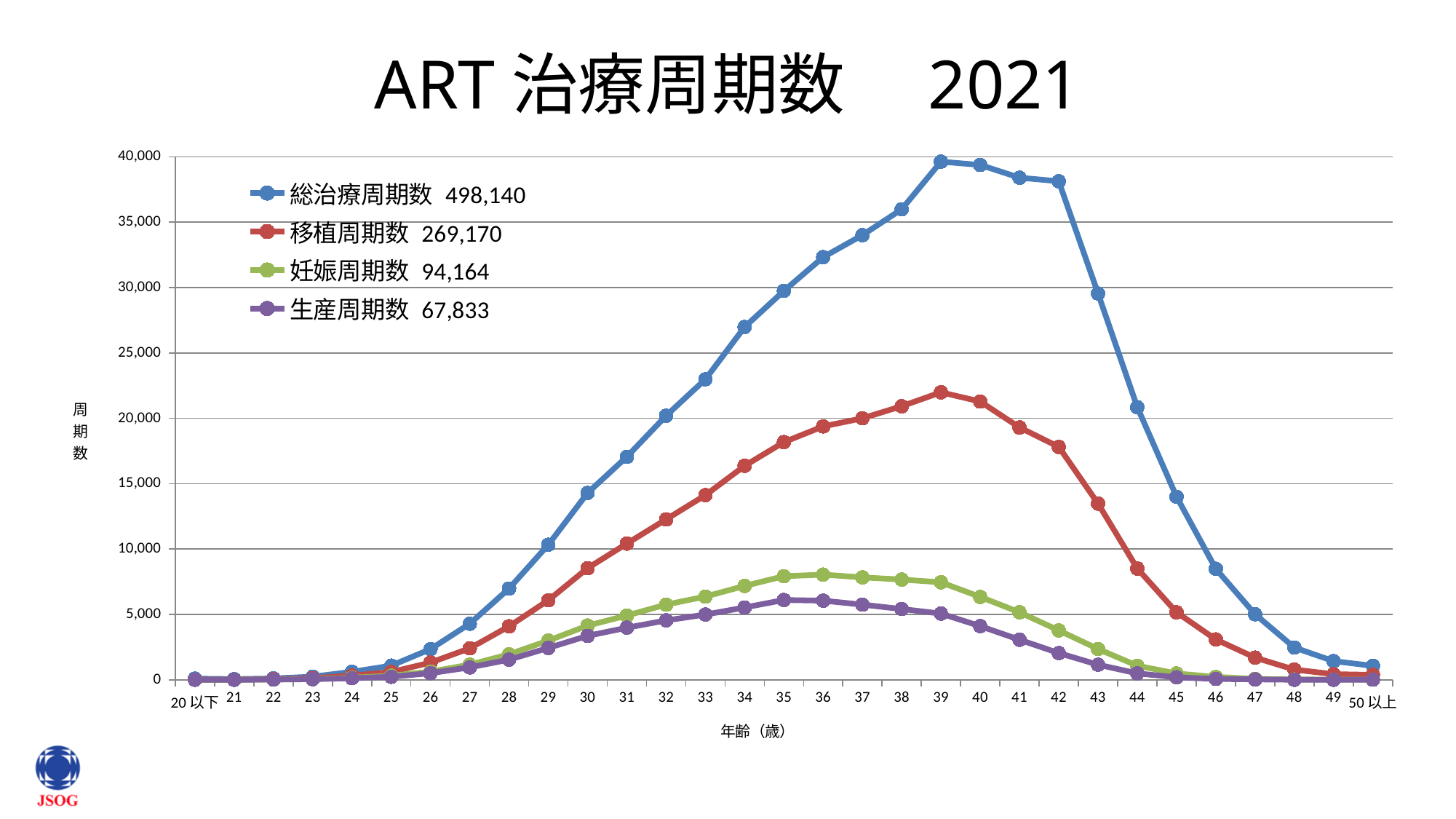
What total is printed in the legend next to 総治療周期数? 498,140 What total is printed in the legend next to 妊娠周期数? 94,164 How many age categories are plotted along the x axis? 31 Is the value of 総治療周期数 at age 39 greater or less than 35,000? greater Is the value of 移植周期数 at age 39 greater or less than 25,000? less What kind of chart is shown on the slide? line chart What total is printed in the legend next to 生産周期数? 67,833 At which age does the 総治療周期数 line reach its highest value? 39 Does the 総治療周期数 line rise or fall between age 42 and age 47? fall How many series does the legend list? 4 What total is printed in the legend next to 移植周期数? 269,170 Which series is higher at age 36, 妊娠周期数 or 生産周期数? 妊娠周期数